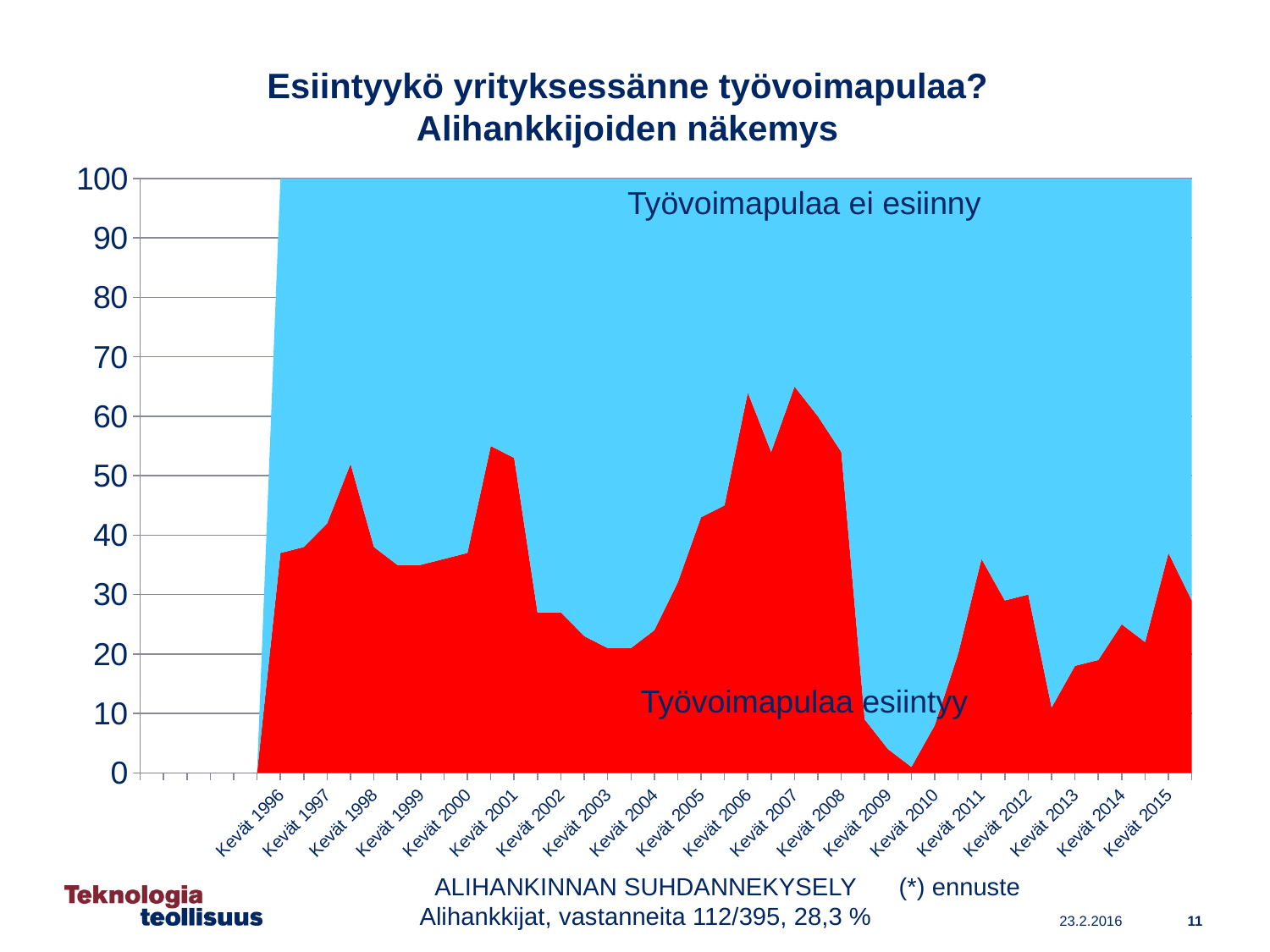
Is the value of 'Työvoimapulaa esiintyy' at Kevät 2007 greater or less than 60? greater Which is larger for 'Työvoimapulaa esiintyy': the value at Kevät 2007 or at Kevät 2010? Kevät 2007 What kind of chart is shown on the slide? Area chart Which series is drawn in red? Työvoimapulaa esiintyy What is the title of the chart? Esiintyykö yrityksessänne työvoimapulaa? Alihankkijoiden näkemys Is the value of 'Työvoimapulaa esiintyy' at Kevät 2003 greater or less than 30? less How many 'Kevät' labels are shown on the x axis? 20 Does the value of 'Työvoimapulaa esiintyy' rise or fall from Kevät 2008 to Kevät 2010? fall Is the value of 'Työvoimapulaa esiintyy' at Kevät 2012 greater or less than 40? less How many series are plotted in the chart? 2